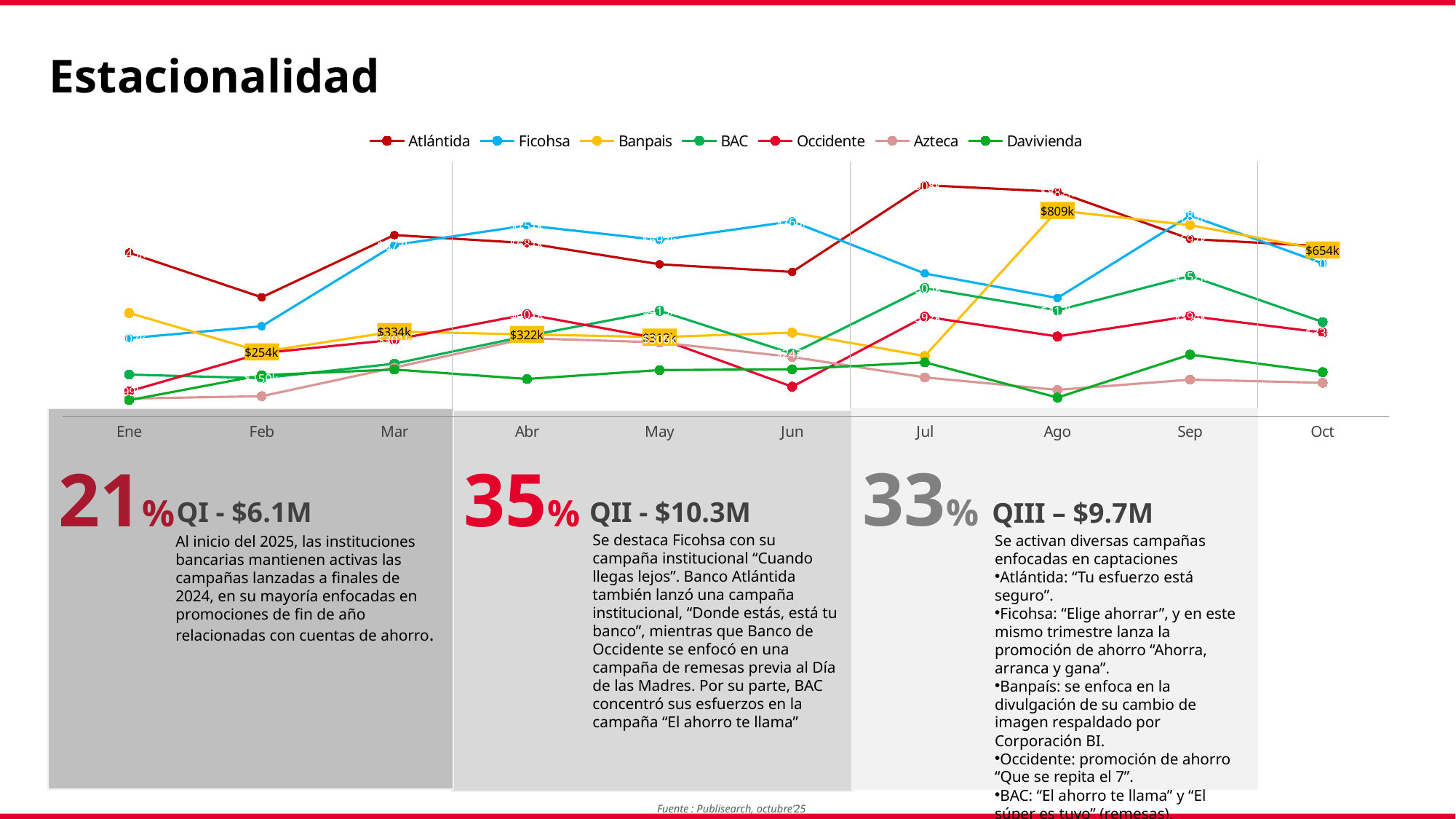
Which is larger for Banpais, the value in Mar or the value in Feb? Mar What is the value for Banpais in Ago? $809k What is the difference between the Banpais values in Ago and Oct? $155k In which month does Banpais reach its highest value? Ago What kind of chart is shown on the slide? line chart What is the value for Banpais in Feb? $254k What is the value for Banpais in Oct? $654k What is the value for Banpais in Mar? $334k How many series does the legend list? 7 Does the Banpais line rise or fall from Jul to Ago? rise How many months are shown along the x axis? 10 Which series has the highest value in Jul? Atlántida